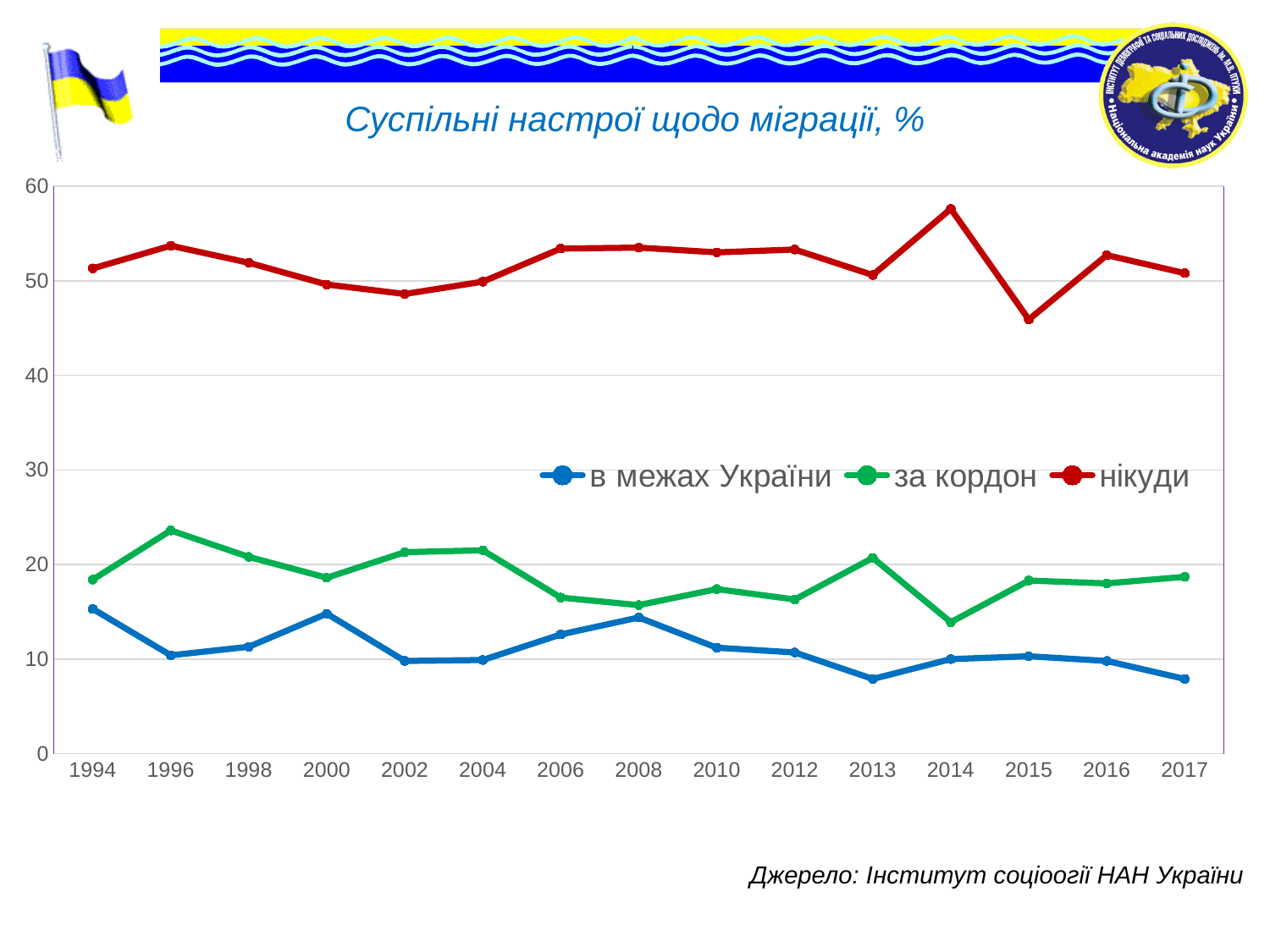
Is the value for "нікуди" in 2014 greater or less than 50? greater In 2017, which series has the larger value: "за кордон" or "в межах України"? за кордон Is the value for "нікуди" in 2015 greater or less than 50? less What kind of chart is shown on the slide? line chart In which year does the series "нікуди" reach its lowest value? 2015 How many series does the legend list? 3 In which year does the series "нікуди" reach its highest value? 2014 How many years are shown on the x axis? 15 What is the title of the chart? Суспільні настрої щодо міграції, % Is the value for "в межах України" in 2013 greater or less than 10? less In which year does the series "за кордон" reach its highest value? 1996 In which year does the series "за кордон" reach its lowest value? 2014